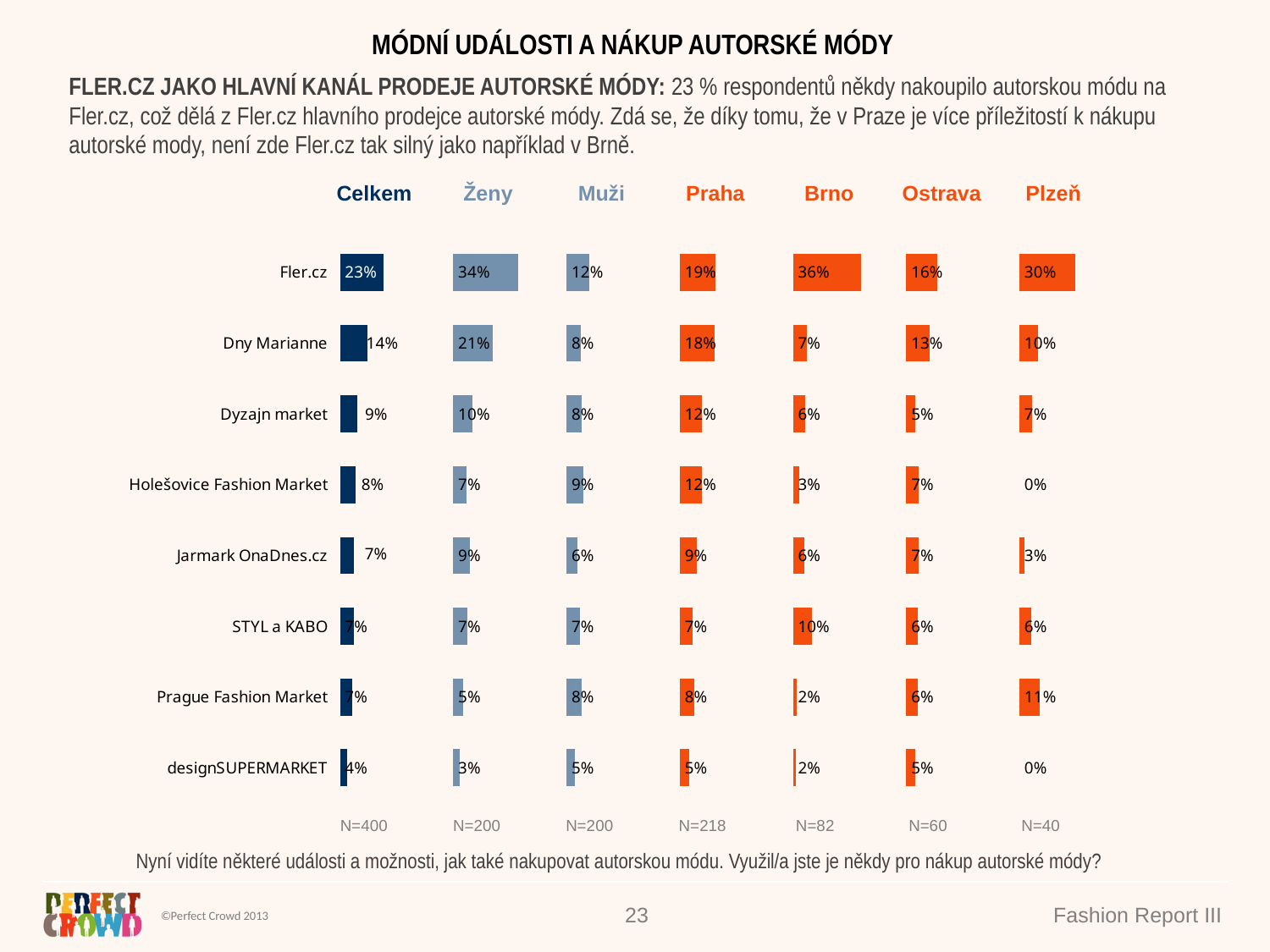
In the Praha chart, which event has the lowest value? designSUPERMARKET In the Ostrava chart, what is the value for Dny Marianne? 13% What is the difference between the Fler.cz values in the Ženy chart and the Muži chart? 22% In the Ženy chart, which event has the highest value? Fler.cz In the Plzeň chart, what is the value for Prague Fashion Market? 11% How many events (categories) are listed in each chart? 8 How many group charts (columns) are shown on the slide? 7 What type of chart is used on this slide? Bar chart For Fler.cz, which is larger: the value in the Praha chart or the value in the Brno chart? Brno In the Celkem chart, what percentage of respondents have bought designer fashion on Fler.cz? 23% What is the sample size (N) shown under the Ostrava chart? N=60 In the Brno chart, what is the value for Fler.cz? 36%